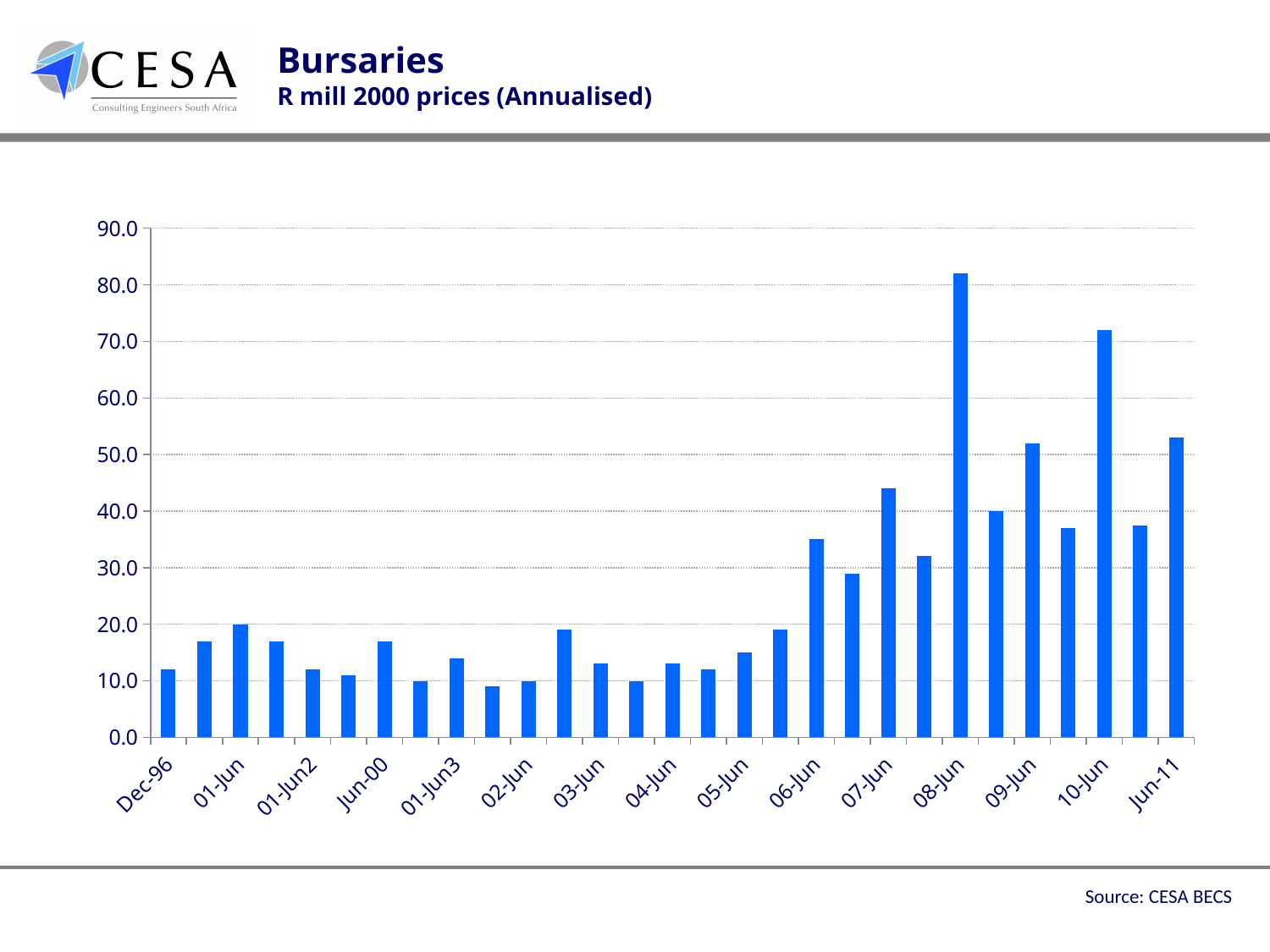
What kind of chart is shown on the slide? bar chart Which is larger, the value for 08-Jun or the value for 10-Jun? 08-Jun What is the title of the chart? Bursaries What source is cited for the chart? CESA BECS Is the value for Dec-96 greater or less than 20? less Which is larger, the value for Jun-11 or the value for 06-Jun? Jun-11 Is the value for 06-Jun greater or less than 30? greater Is the value for 03-Jun greater or less than 20? less Do the bursaries values generally rise or fall from Dec-96 to Jun-11? rise Which labelled period has the highest bursaries value? 08-Jun